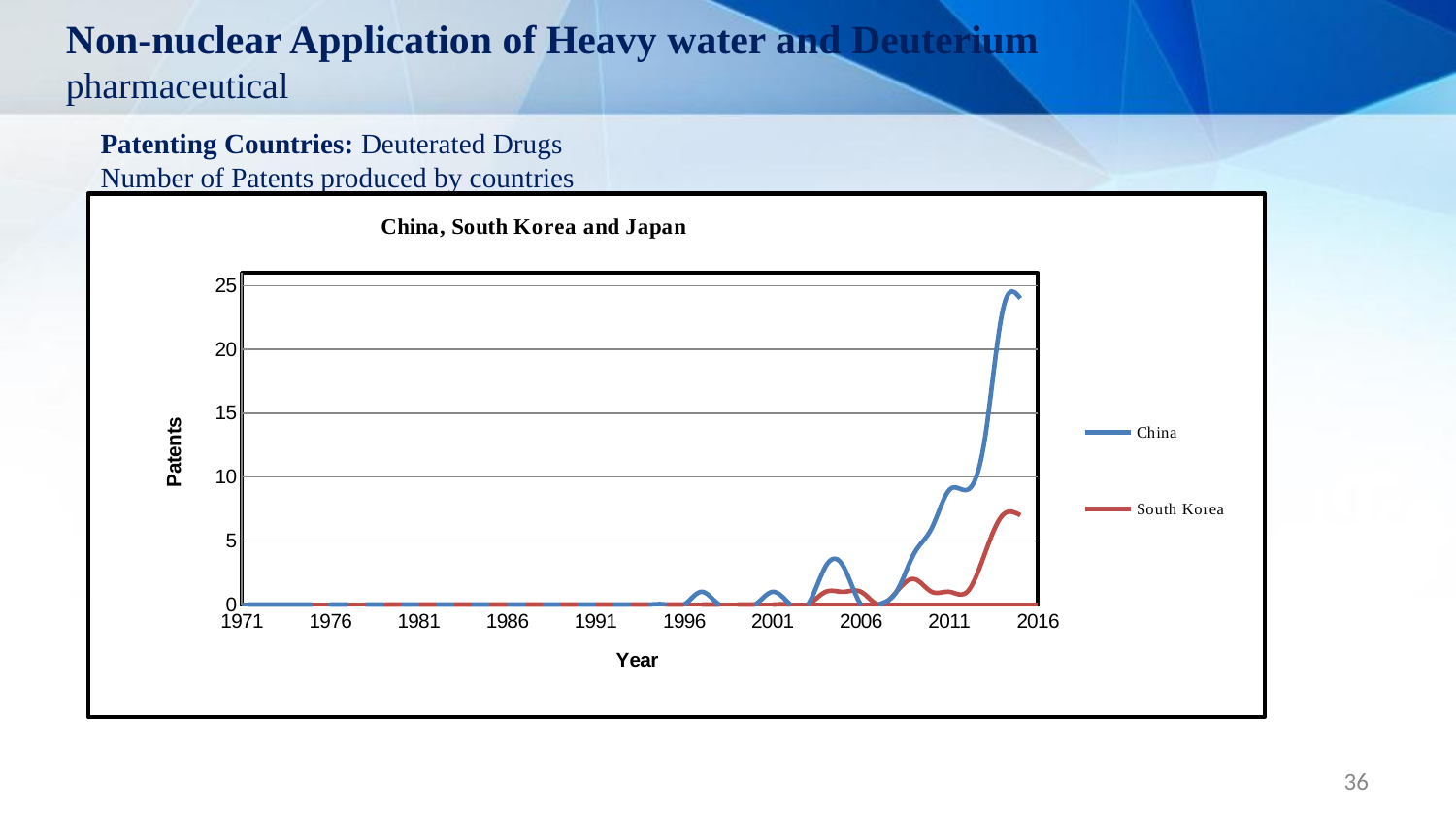
What is the label of the vertical axis of the chart? Patents What is the title of the chart? China, South Korea and Japan Is the value for China around 2005 greater or less than 5? less Is the peak value for China (around 2015) greater or less than 20? greater Is the peak value for South Korea (around 2015) greater or less than 5? greater How many series does the chart's legend list? 2 Which series reaches the highest number of patents in the chart? China Does the number of patents for China rise or fall between 2006 and 2015? rise Which series reaches the higher value at the right end of the chart, China or South Korea? China Which series is drawn in blue in the chart? China What kind of chart is shown on the slide? line chart